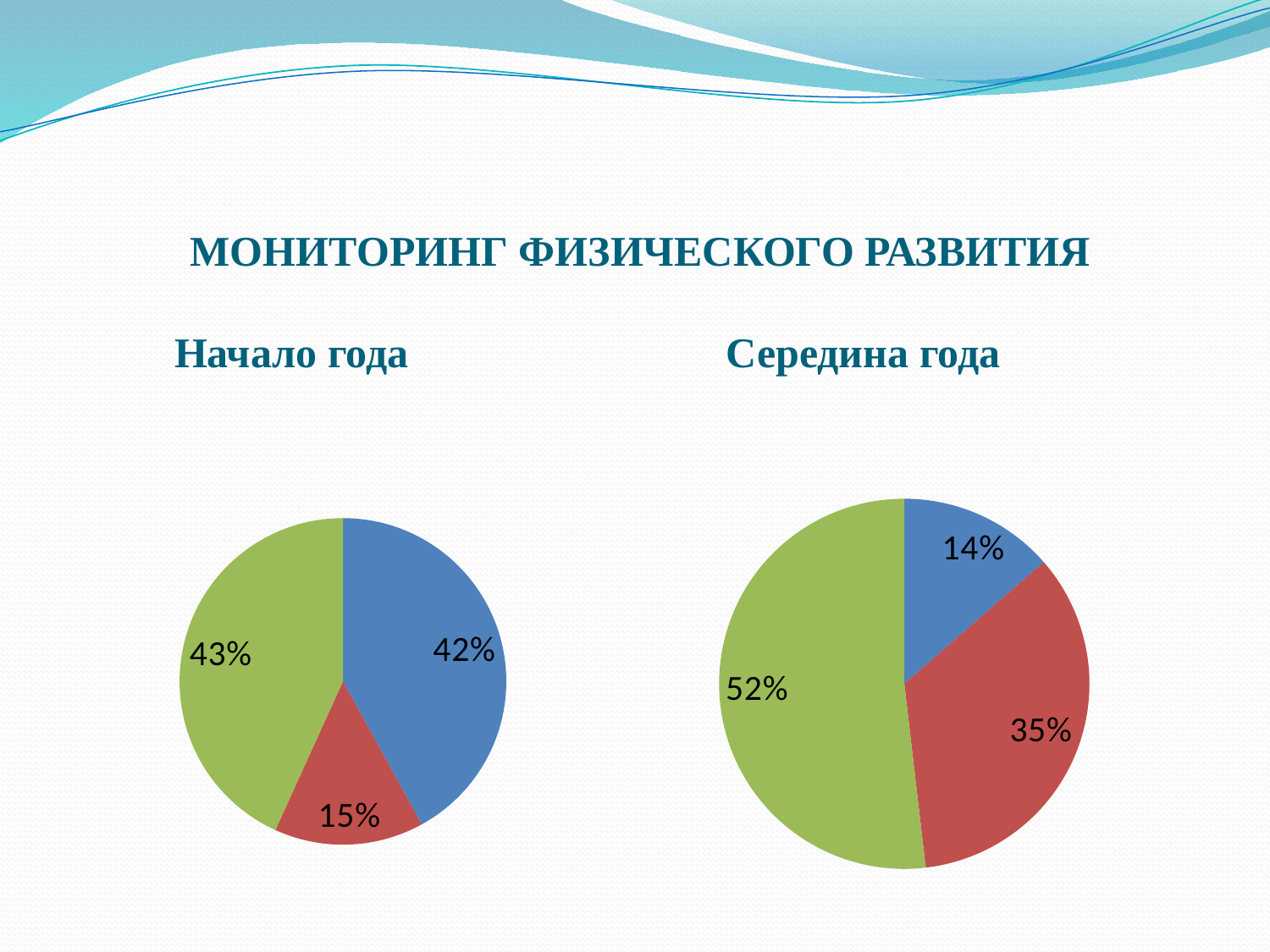
In the "Середина года" chart, what percentage does the blue slice show? 14% In the "Середина года" chart, which colour slice is the smallest? blue Which is larger: the red slice in "Начало года" or the red slice in "Середина года"? Середина года In the "Середина года" chart, what percentage does the green slice show? 52% What is the title of the slide above the two pie charts? МОНИТОРИНГ ФИЗИЧЕСКОГО РАЗВИТИЯ In the "Начало года" chart, what percentage does the blue slice show? 42% What type of chart is shown under "Начало года"? pie chart In the "Начало года" chart, what percentage does the red slice show? 15% In the "Середина года" chart, which colour slice is the largest? green In the "Начало года" chart, which colour slice is the smallest? red How many slices does the "Начало года" pie chart have? 3 In the "Середина года" chart, what is the difference between the green slice and the red slice? 17%